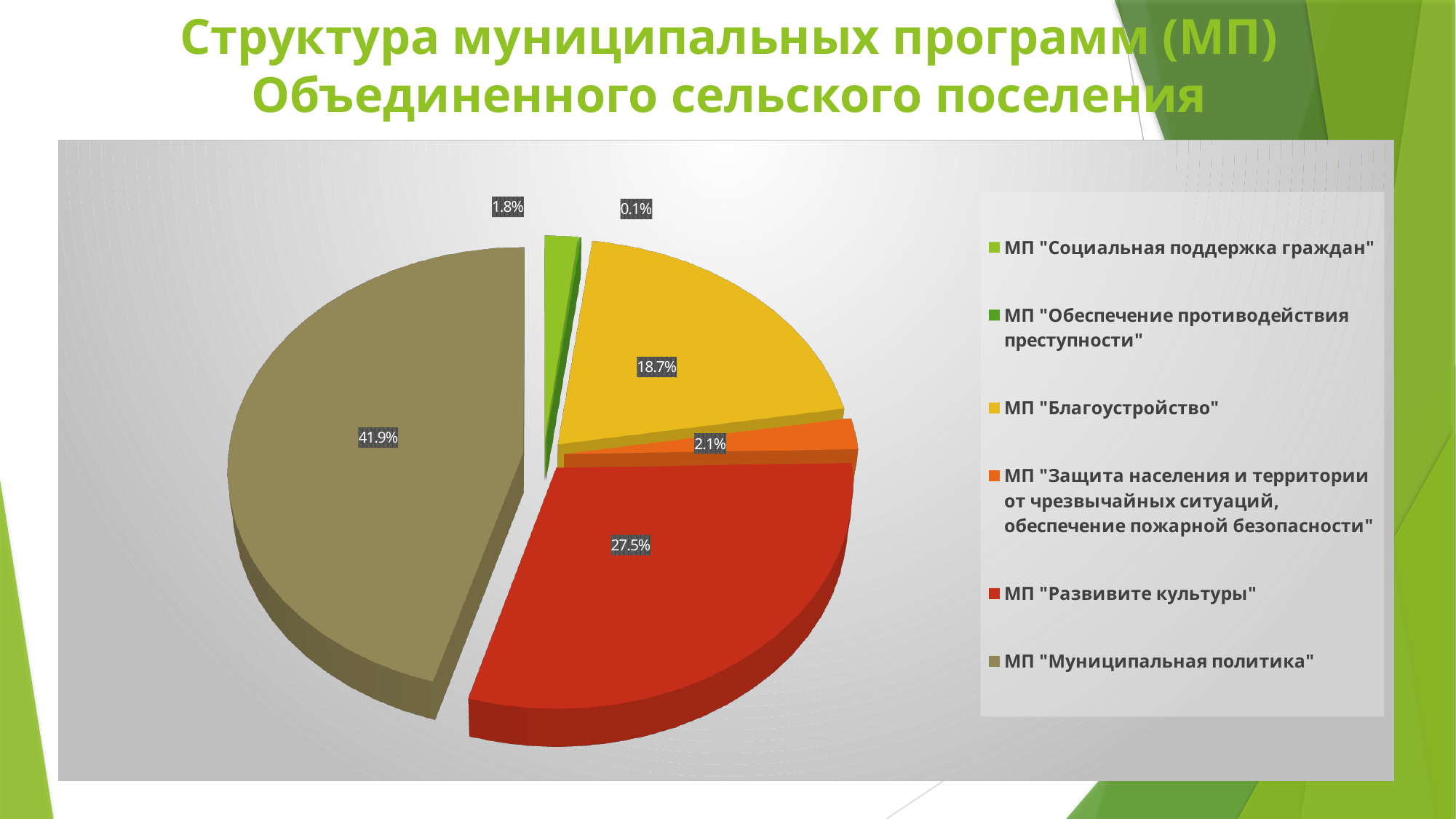
Which has a larger share: МП "Благоустройство" or МП "Развивите культуры"? МП "Развивите культуры" What kind of chart is shown on the slide? pie chart What share of the pie does МП "Защита населения и территории от чрезвычайных ситуаций, обеспечение пожарной безопасности" have? 2.1% What is the title of the slide containing the pie chart? Структура муниципальных программ (МП) Объединенного сельского поселения What share of the pie does МП "Развивите культуры" have? 27.5% What share of the pie does МП "Благоустройство" have? 18.7% What is the difference in percentage points between МП "Муниципальная политика" and МП "Развивите культуры"? 14.4 Which municipal programme has the smallest share of the pie? МП "Обеспечение противодействия преступности" How many slices does the pie chart have? 6 What share of the pie does МП "Муниципальная политика" have? 41.9% What share of the pie does МП "Социальная поддержка граждан" have? 1.8% Which municipal programme has the largest share of the pie? МП "Муниципальная политика"